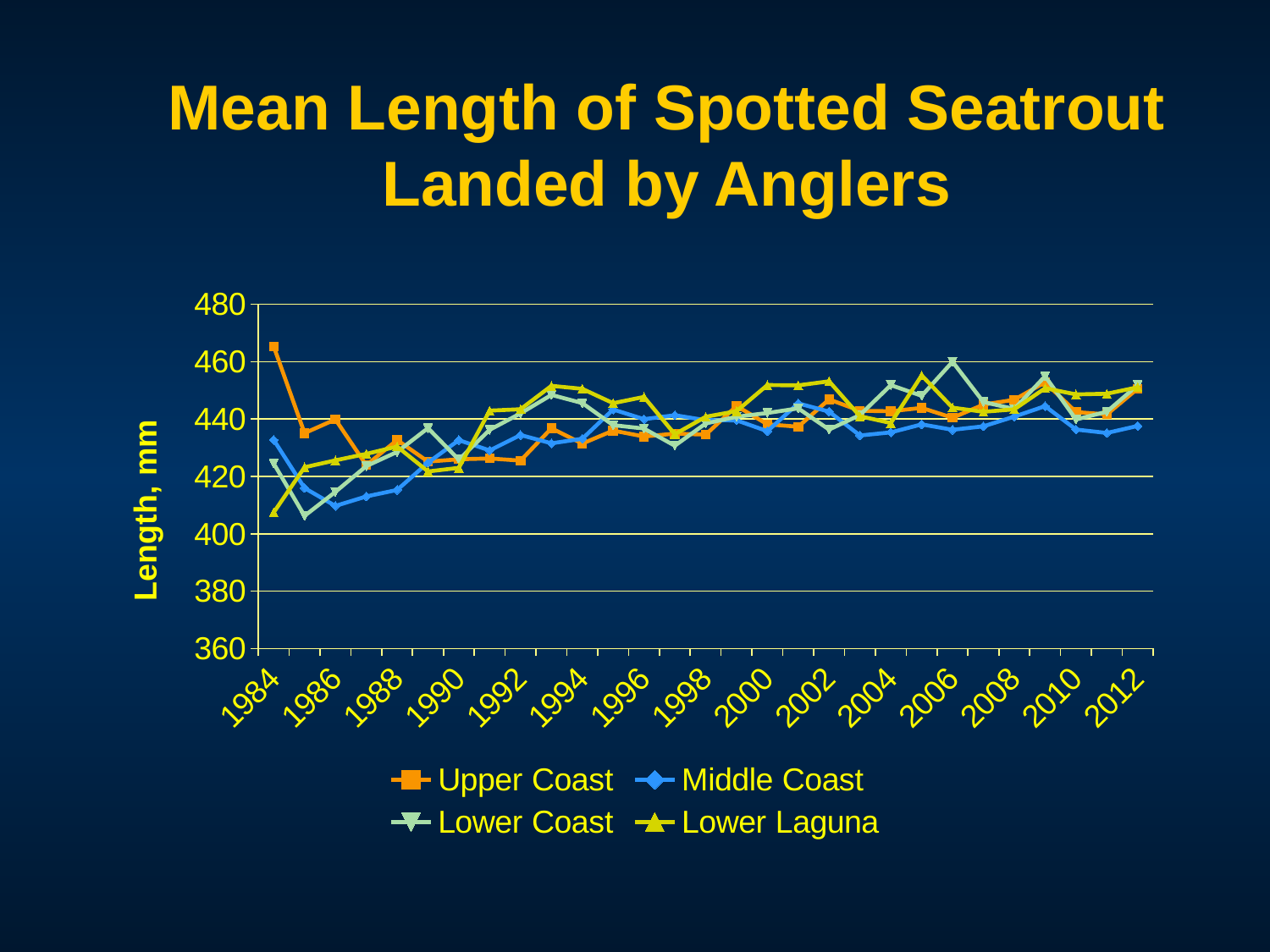
What is the title of the chart? Mean Length of Spotted Seatrout Landed by Anglers Which series has the lowest value in 1984? Lower Laguna What kind of chart is shown on the slide? line chart Does the Lower Laguna series rise or fall overall from 1984 to 2012? rise In 2012, which is larger: the value for Lower Laguna or the value for Middle Coast? Lower Laguna Is the value for Lower Laguna in 1984 greater or less than 420? less What is the label on the y axis? Length, mm Is the value for Upper Coast in 2012 greater or less than 440? greater Which series has the highest value in 1984? Upper Coast Is the value for Upper Coast in 1984 greater or less than 460? greater How many series does the legend list? 4